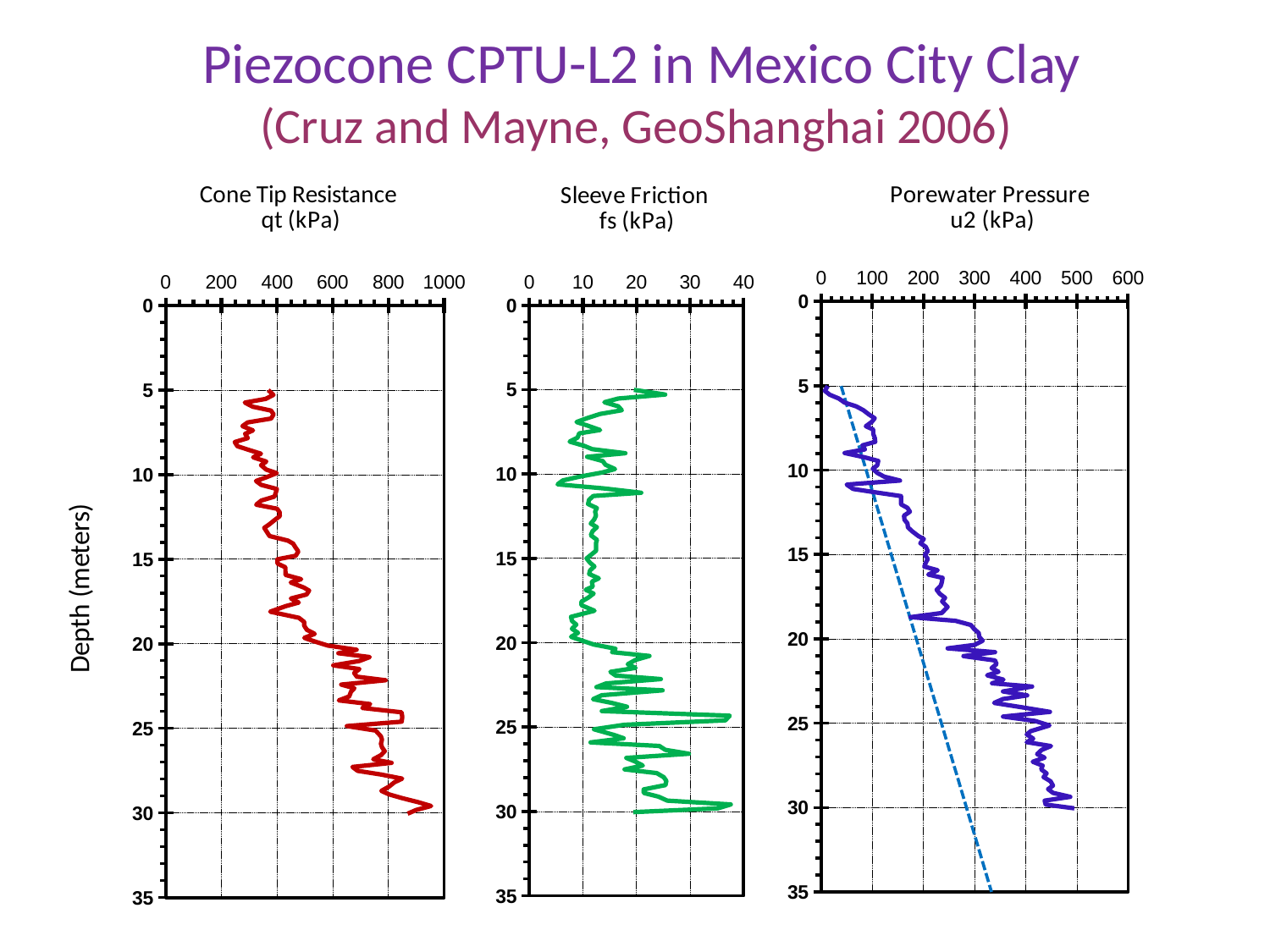
In the Cone Tip Resistance chart, is the value at a depth of 5 meters greater or less than 600? less In the Cone Tip Resistance chart, which is larger: the value at a depth of 5 meters or the value at a depth of 30 meters? 30 meters In the Porewater Pressure chart, does u2 generally increase or decrease as depth increases from 5 to 30 meters? increase What kind of chart is the Cone Tip Resistance chart? line chart How many charts are shown on the slide? 3 In the Sleeve Friction chart, is the value at a depth of 15 meters greater or less than 20? less In the Porewater Pressure chart, is the value at a depth of 30 meters greater or less than 400? greater What is the title of the slide? Piezocone CPTU-L2 in Mexico City Clay What is the largest value shown on the x axis of the Porewater Pressure chart? 600 In the Cone Tip Resistance chart, does qt generally increase or decrease as depth increases from 5 to 30 meters? increase